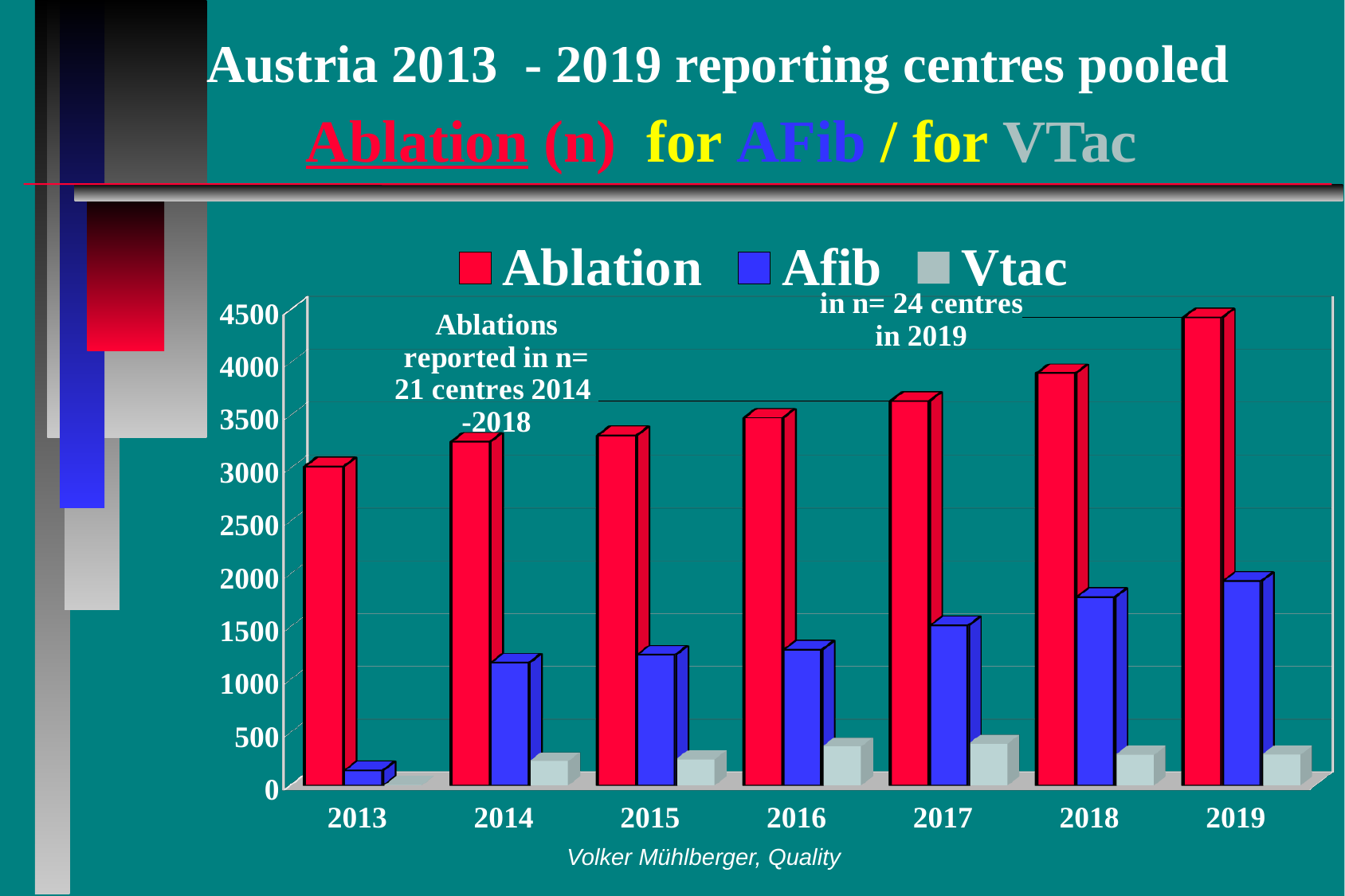
In which year is the Afib value highest? 2019 In 2019, which is larger, the Ablation value or the Afib value? Ablation In which year is the Ablation value highest? 2019 Is the Ablation value for 2019 greater or less than 4000? greater In which year is the Ablation value lowest? 2013 Do the Ablation values rise or fall from 2013 to 2019? rise In which year is the Afib value lowest? 2013 How many years are shown on the x axis? 7 How many series does the legend list? 3 Which colour represents the Vtac series in the legend? grey Is the Afib value for 2013 greater or less than 500? less What kind of chart is shown on the slide? bar chart